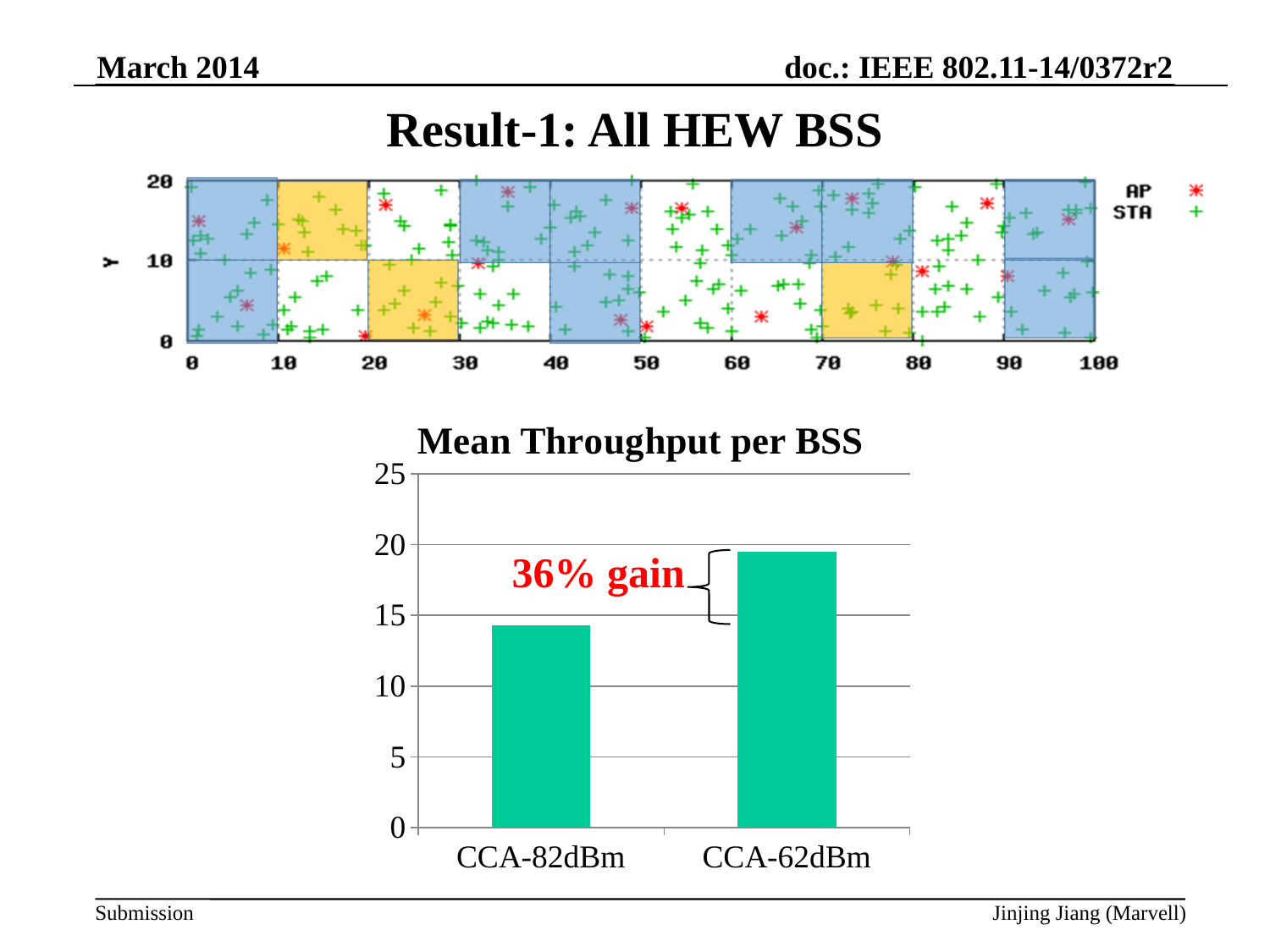
In the Mean Throughput per BSS chart, is the value for CCA-62dBm greater or less than 20? less In the top chart showing the AP and STA layout, how many series does the legend list? 2 In the Mean Throughput per BSS chart, is the value for CCA-62dBm greater or less than 15? greater In the Mean Throughput per BSS chart, what gain is annotated between the two bars? 36% gain In the Mean Throughput per BSS chart, which is larger, the value for CCA-82dBm or the value for CCA-62dBm? CCA-62dBm In the Mean Throughput per BSS chart, is the value for CCA-82dBm greater or less than 15? less In the Mean Throughput per BSS chart, what kind of chart is shown? bar chart In the Mean Throughput per BSS chart, which category has the lowest value? CCA-82dBm In the Mean Throughput per BSS chart, how many categories are plotted? 2 In the top chart showing the AP and STA layout, what are the two legend entries? AP and STA In the Mean Throughput per BSS chart, which category has the highest value? CCA-62dBm